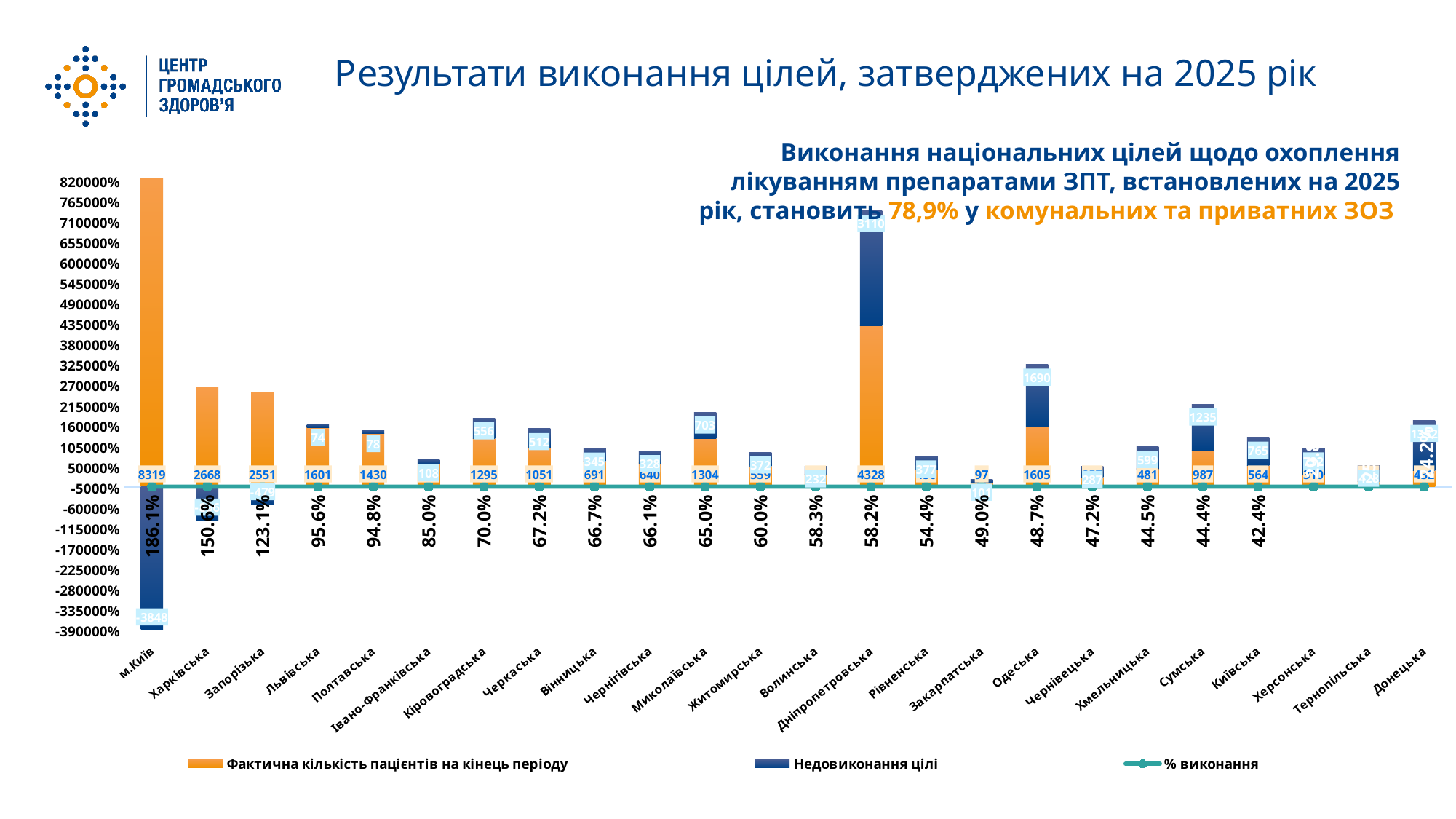
Which has a larger actual number of patients, Харківська or Запорізька? Харківська What is the % виконання value shown for м.Київ? 186.1% What is the Недовиконання цілі value labelled for Одеська? 1690 Which region has the highest actual number of patients at the end of the period? м.Київ What is the difference between the actual number of patients for Харківська (2668) and Запорізька (2551)? 117 What is the % виконання value shown for Львівська? 95.6% What is the actual number of patients at the end of the period for м.Київ? 8319 How many regions are shown on the x axis of the chart? 24 How many series does the chart legend list? 3 What is the Недовиконання цілі value labelled for Дніпропетровська? 3110 What is the actual number of patients at the end of the period for Дніпропетровська? 4328 Which series in the legend is shown in orange? Фактична кількість пацієнтів на кінець періоду